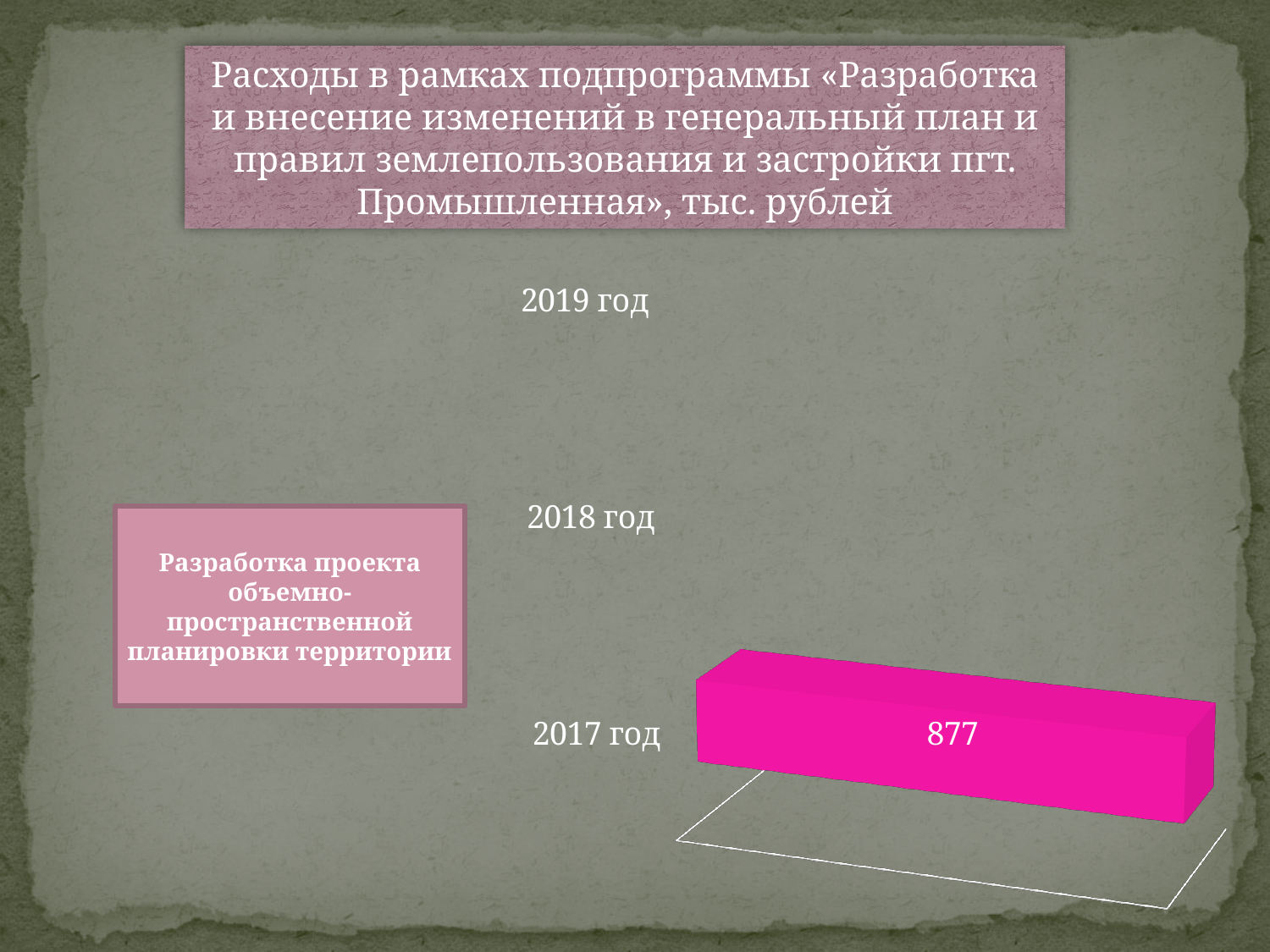
Which year has the highest value on the chart? 2017 год Which year is the only one with a visible bar on the chart? 2017 год What series name is shown in the box to the left of the chart? Разработка проекта объемно-пространственной планировки территории Which years are listed on the chart's axis? 2017 год, 2018 год, 2019 год How many year categories are listed on the chart's axis? 3 Is the value for 2017 год greater or less than 500? greater What is the value shown for 2017 год? 877 What kind of chart is shown on the slide? bar chart